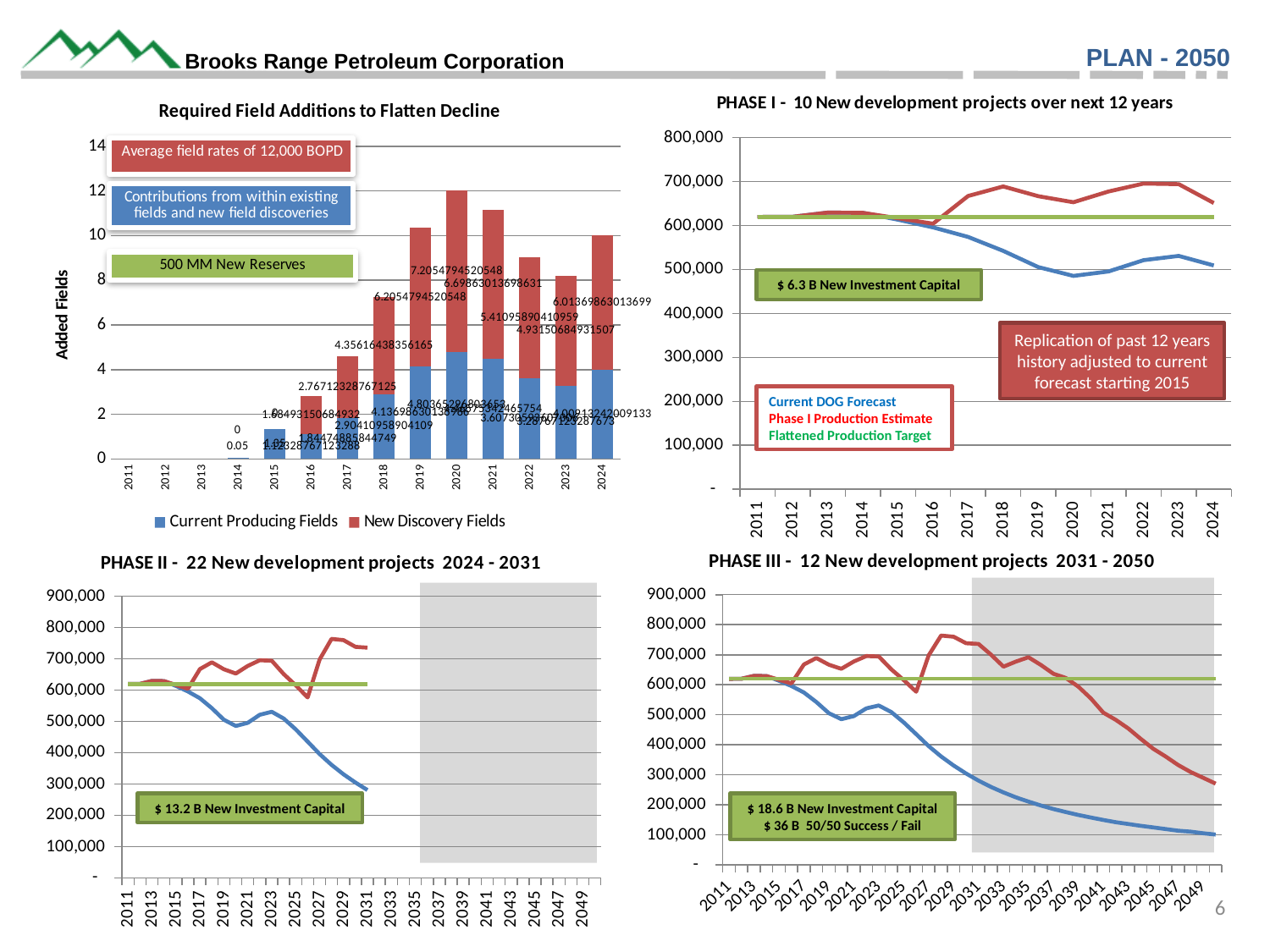
In the 'PHASE I - 10 New development projects over next 12 years' chart, does the Current DOG Forecast line rise or fall from 2011 to 2024? fall How many years are shown on the x axis of the 'Required Field Additions to Flatten Decline' chart? 14 In the 'Required Field Additions to Flatten Decline' chart, which year has the tallest stacked bar? 2020 What kind of chart is the 'PHASE I - 10 New development projects over next 12 years' chart? line chart What investment capital amount is stated in the box on the 'PHASE II - 22 New development projects 2024 - 2031' chart? $ 13.2 B New Investment Capital What kind of chart is the 'Required Field Additions to Flatten Decline' chart? bar chart In the 'Required Field Additions to Flatten Decline' chart, is the total stacked bar for 2017 greater or less than 6? less How many series does the legend of the 'Required Field Additions to Flatten Decline' chart list? 2 In the 'PHASE I - 10 New development projects over next 12 years' chart, is the Phase I Production Estimate value for 2022 greater or less than 600,000? greater In the 'Required Field Additions to Flatten Decline' chart, is the total stacked bar for 2020 greater or less than 10? greater How many series are named in the text box on the 'PHASE I - 10 New development projects over next 12 years' chart? 3